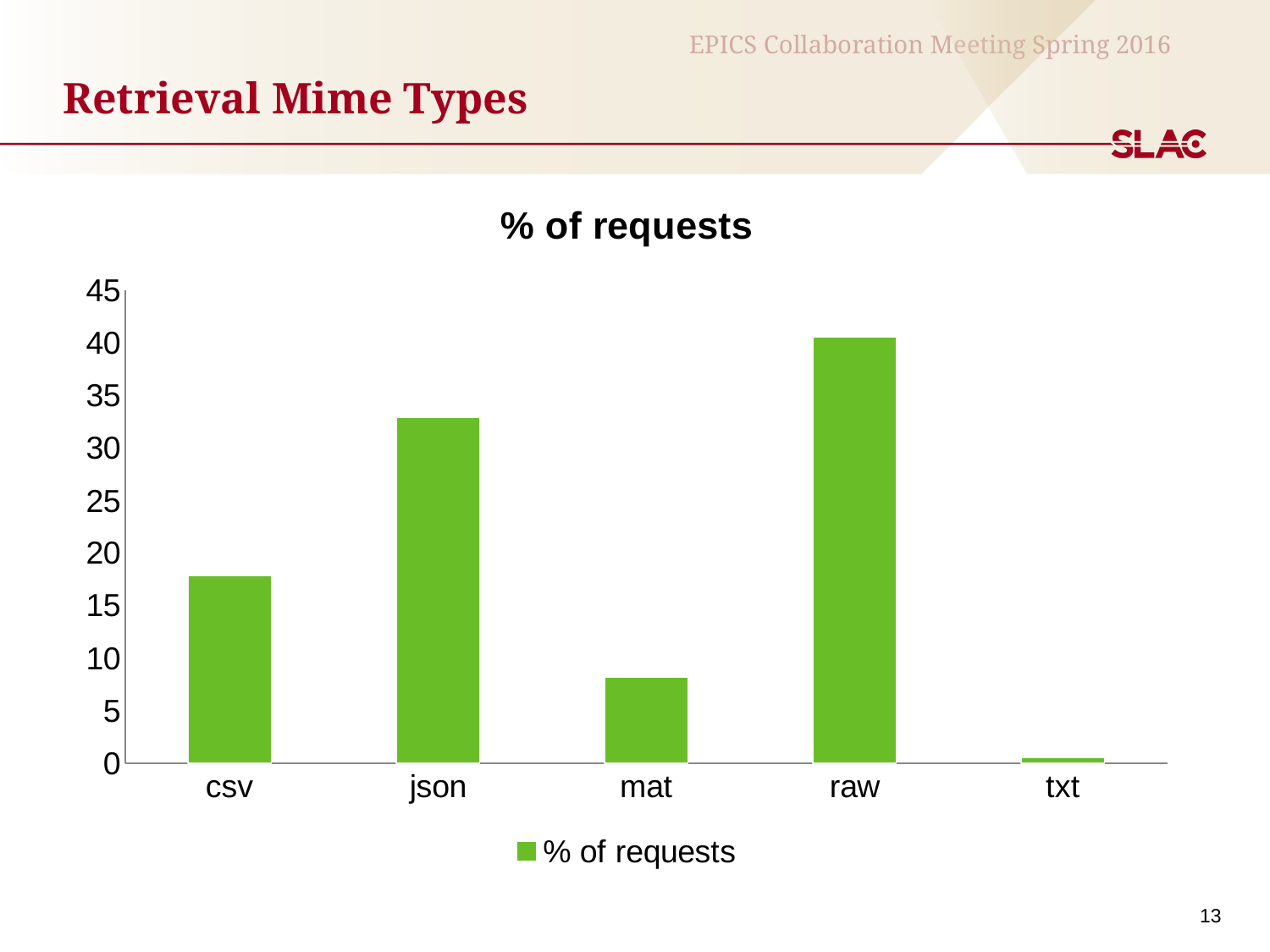
How many categories are shown on the x axis of the chart? 5 What is the title of the chart? % of requests Which category has the highest % of requests? raw Which has a larger % of requests, csv or json? json Which has a larger % of requests, mat or csv? csv Is the value for json greater or less than 30? greater How many series does the legend list? 1 Which category has the lowest % of requests? txt What type of chart is shown on the slide? bar chart Is the value for mat greater or less than 10? less Is the value for csv greater or less than 20? less